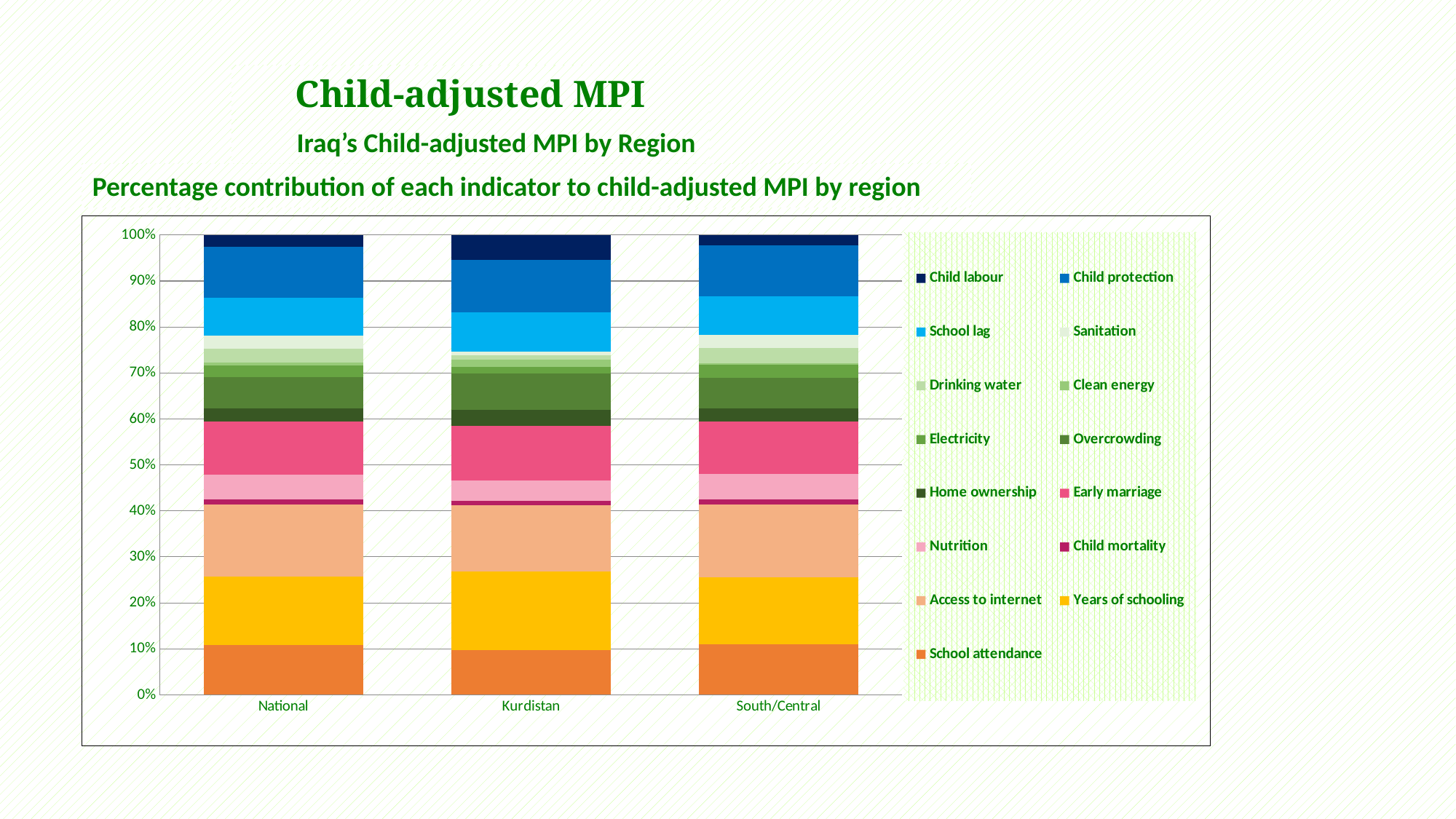
Which indicator forms the bottom segment of each bar? School attendance What is the title printed above the chart? Percentage contribution of each indicator to child-adjusted MPI by region Is the Child labour segment for National greater or less than 10%? less Is the Sanitation contribution larger for National or for Kurdistan? National What is the total height of the National stacked bar? 100% How many indicators does the legend list? 15 Is the Access to internet segment for National greater or less than 10%? greater Is the Child labour contribution larger for Kurdistan or for National? Kurdistan What kind of chart is shown on the slide? Stacked bar chart Is the Years of schooling segment for Kurdistan greater or less than 10%? greater How many regions (categories) are shown on the x axis? 3 Which region has the largest Child labour segment? Kurdistan